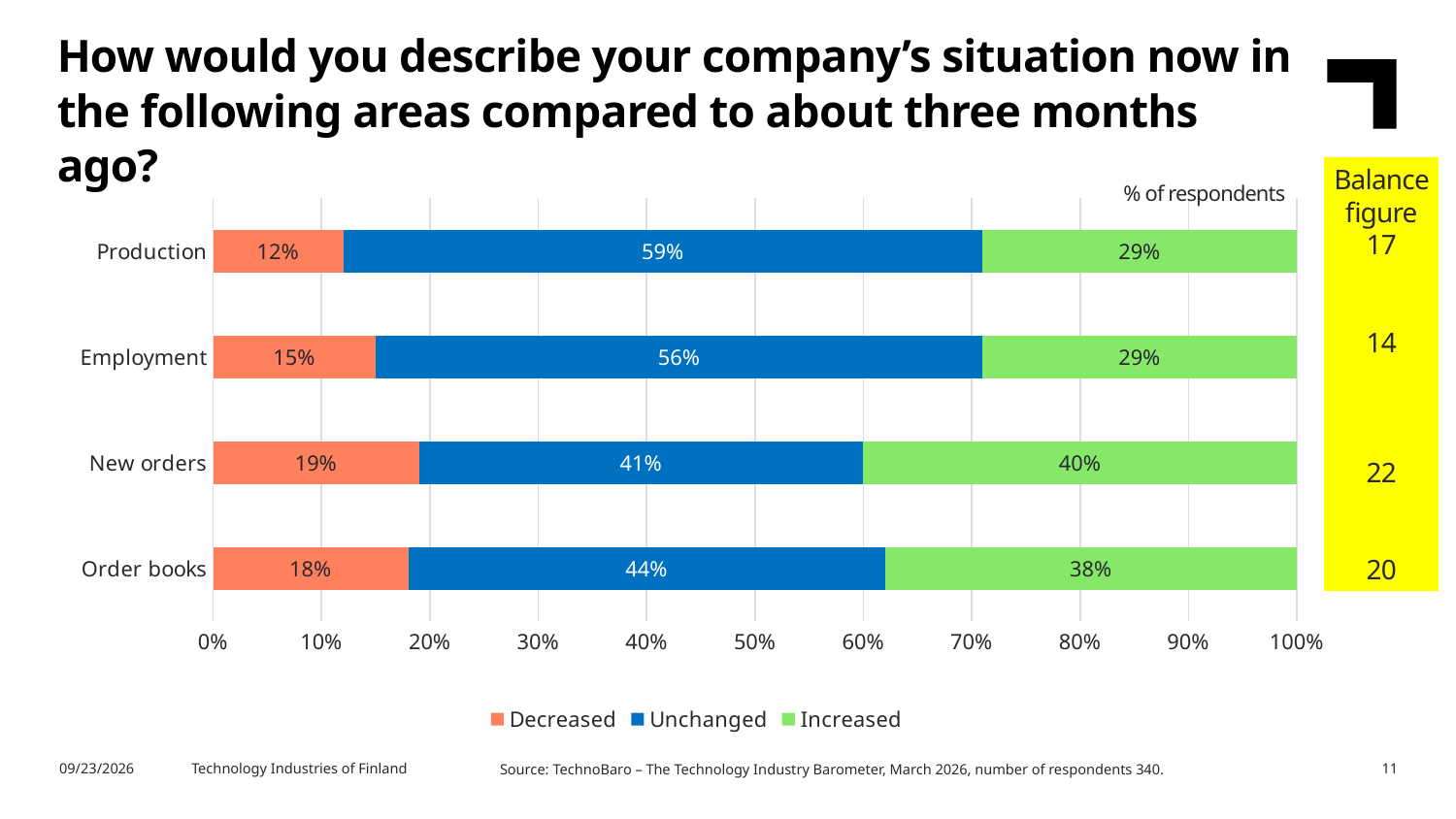
What kind of chart is shown on the slide? Stacked bar chart Which category has the lowest share of respondents reporting a decrease? Production Which category has the highest share of respondents reporting a decrease? New orders What is the balance figure shown for New orders? 22 What percentage of respondents reported that Production was unchanged? 59% How many categories are shown on the chart? 4 How many series does the legend list? 3 What percentage of respondents reported that Employment was unchanged? 56% Which is larger: the Unchanged share for Order books or the Unchanged share for New orders? Order books What is the difference between the Increased share for New orders and the Increased share for Production? 11 percentage points What percentage of respondents reported that New orders increased? 40% What percentage of respondents reported that Order books decreased? 18%